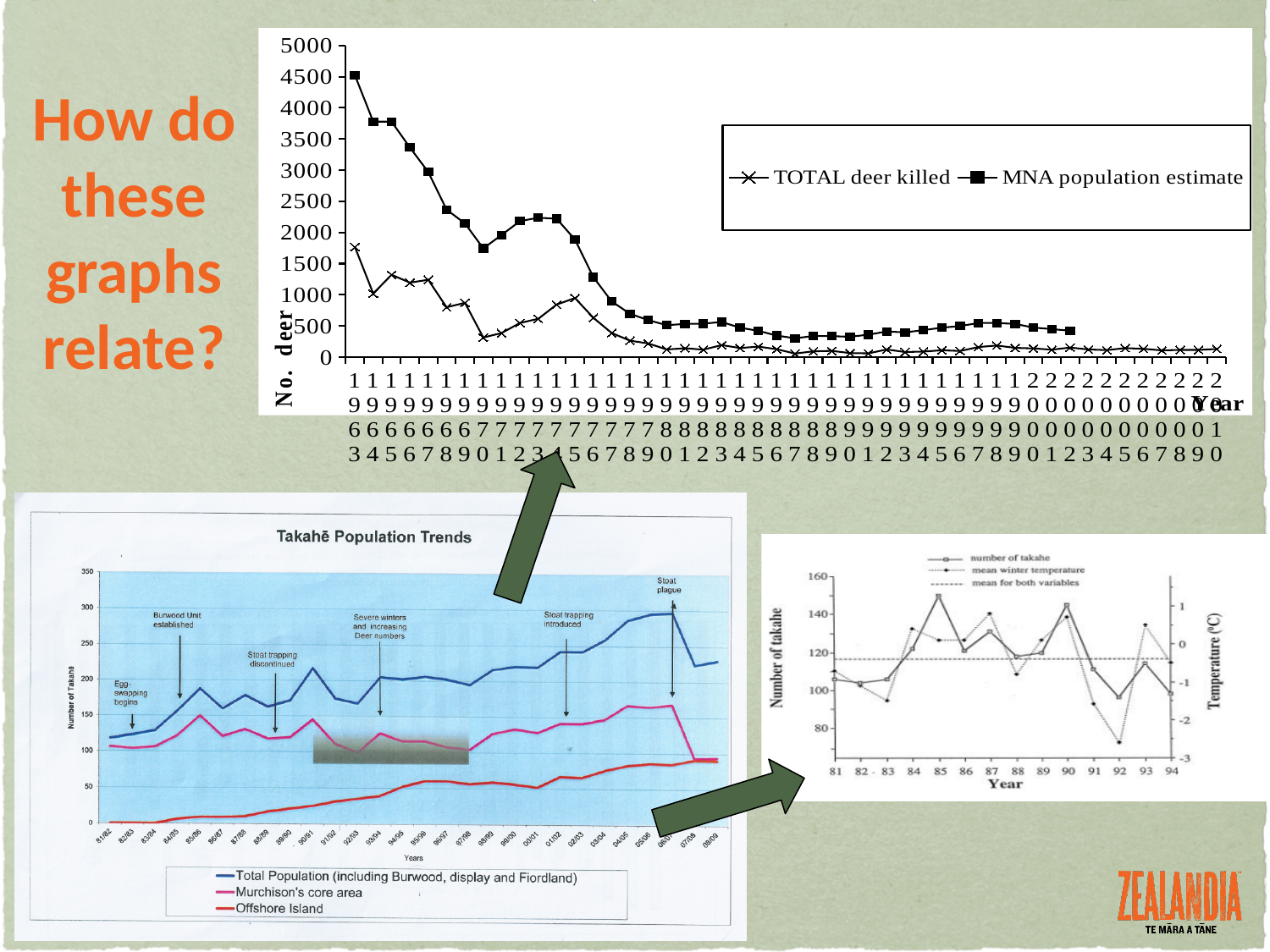
In the bottom-right chart, what is the label of the right-hand vertical axis? Temperature (°C) In the top deer chart, which series is higher in 1963, TOTAL deer killed or MNA population estimate? MNA population estimate In the bottom-left Takahē Population Trends chart, does the Offshore Island line generally rise or fall from 81/82 to 08/09? rise In the bottom-left Takahē Population Trends chart, how many series does the legend list? 3 In the bottom-right chart, is the number of takahe in 85 greater or less than 140? greater In the top deer chart, is the TOTAL deer killed value for 1963 greater or less than 1500? greater What kind of chart is the top chart showing deer numbers? line chart In the top deer chart, does the MNA population estimate generally rise or fall from 1963 to 2010? fall In the top deer chart, how many series does the legend list? 2 In the bottom-left Takahē Population Trends chart, is the Total Population value for 81/82 greater or less than 100? greater What is the title of the bottom-left chart? Takahē Population Trends